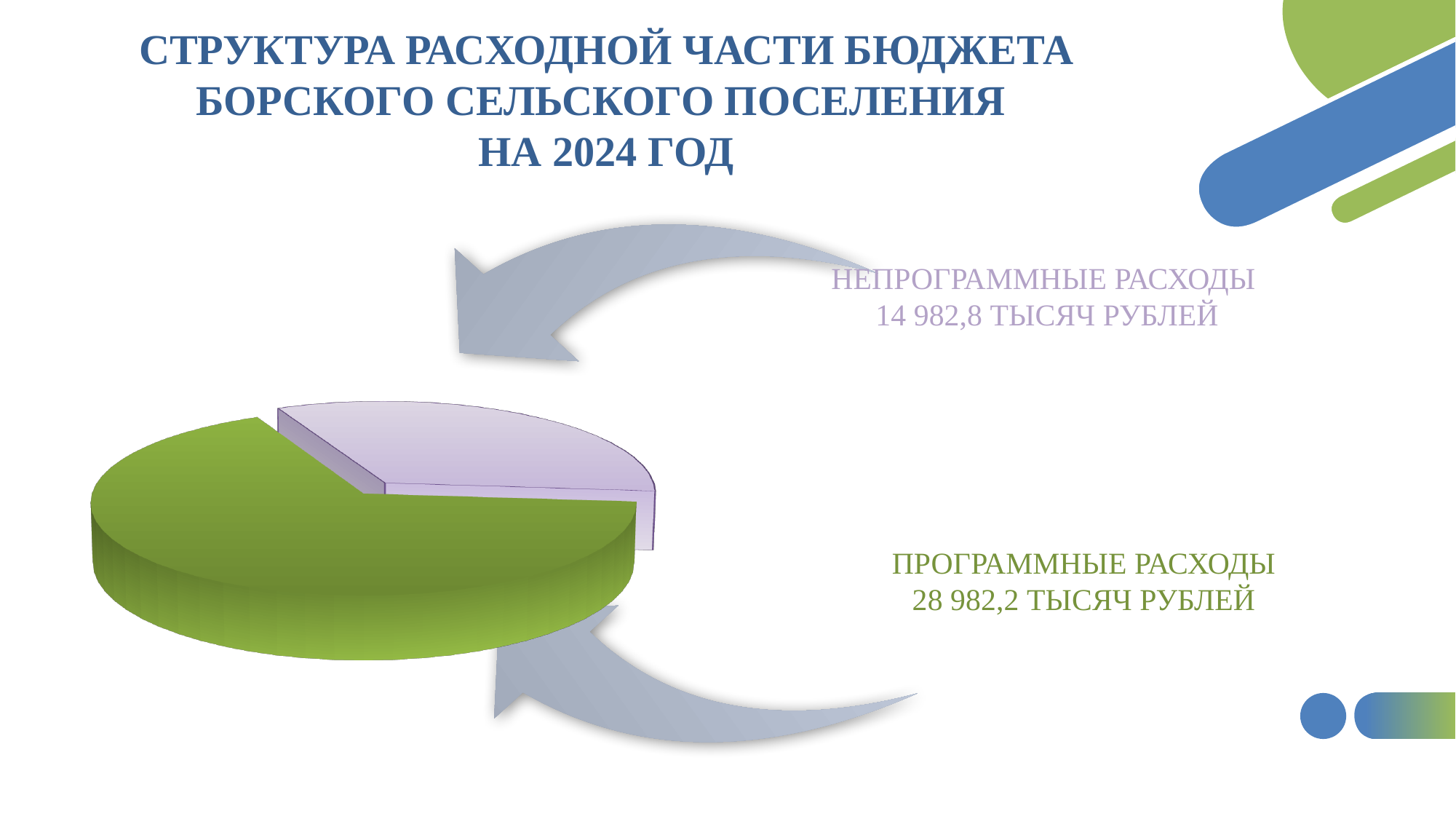
What is the difference between ПРОГРАММНЫЕ РАСХОДЫ and НЕПРОГРАММНЫЕ РАСХОДЫ, in thousand rubles? 13 999,4 What is the value for ПРОГРАММНЫЕ РАСХОДЫ? 28 982,2 тысяч рублей Which category has the smallest slice of the pie? НЕПРОГРАММНЫЕ РАСХОДЫ What kind of chart is shown on the slide? Pie chart Which is larger, ПРОГРАММНЫЕ РАСХОДЫ or НЕПРОГРАММНЫЕ РАСХОДЫ? ПРОГРАММНЫЕ РАСХОДЫ Which year does the budget expenditure structure on the slide refer to? 2024 What is the value for НЕПРОГРАММНЫЕ РАСХОДЫ? 14 982,8 тысяч рублей What is the total of the two categories shown in the pie chart, in thousand rubles? 43 965,0 Which category has the largest slice of the pie? ПРОГРАММНЫЕ РАСХОДЫ What colour is the slice for НЕПРОГРАММНЫЕ РАСХОДЫ? Light purple What colour is the slice for ПРОГРАММНЫЕ РАСХОДЫ? Green How many slices does the pie chart have? 2